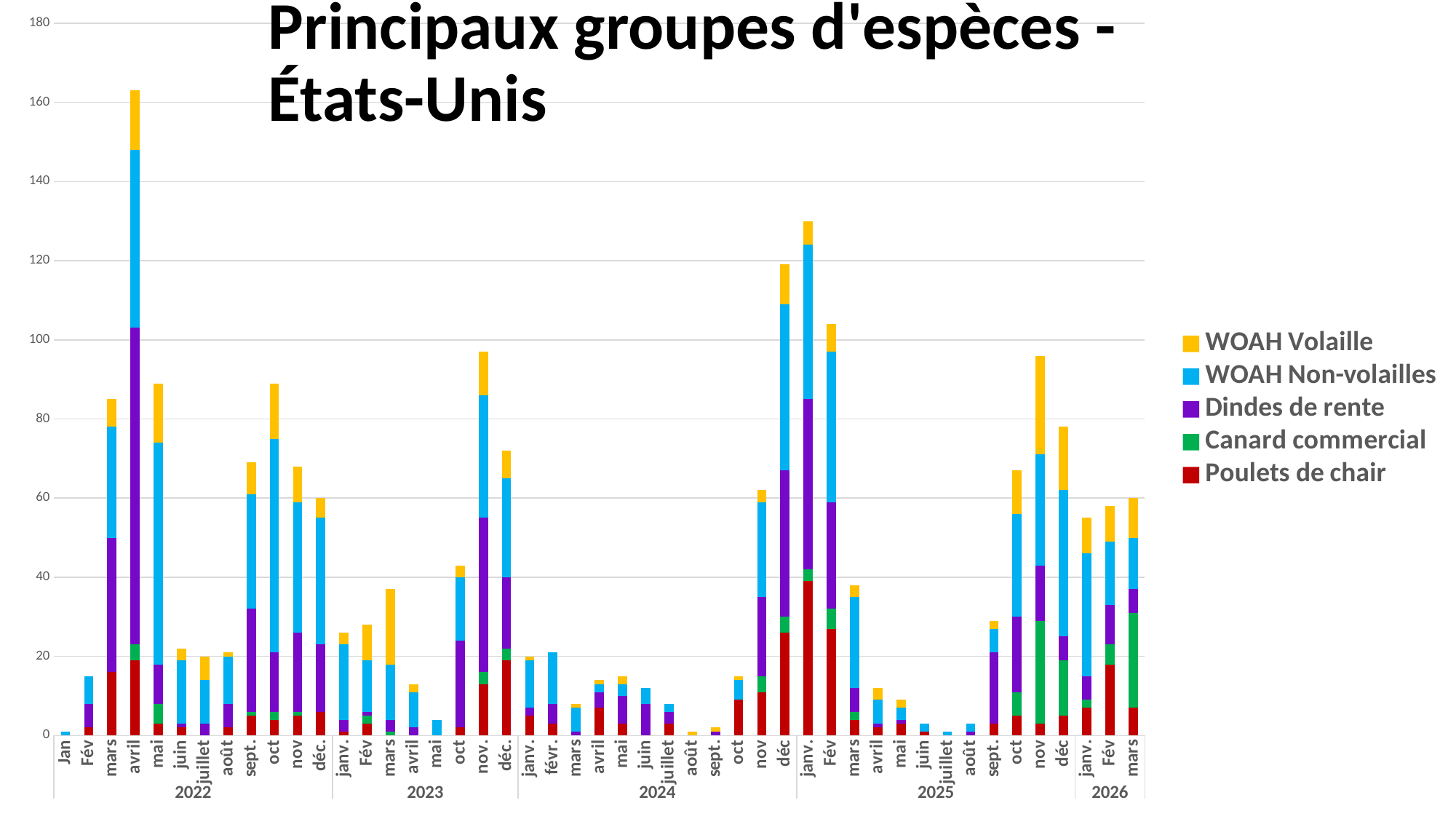
How many series does the legend list? 5 Is the total for nov 2025 greater or less than 80? greater Which colour represents 'Poulets de chair' in the legend? Red Is the total for janv. 2025 greater or less than 120? greater Which total is larger, avril 2022 or janv. 2025? avril 2022 How many years are shown along the x axis? 5 Is the total for avril 2022 greater or less than 140? greater What is the title of the chart? Principaux groupes d'espèces - États-Unis Which month has the highest total bar in the chart? avril 2022 Which total is larger, déc 2024 or nov. 2023? déc 2024 What kind of chart is shown on the slide? Stacked bar chart